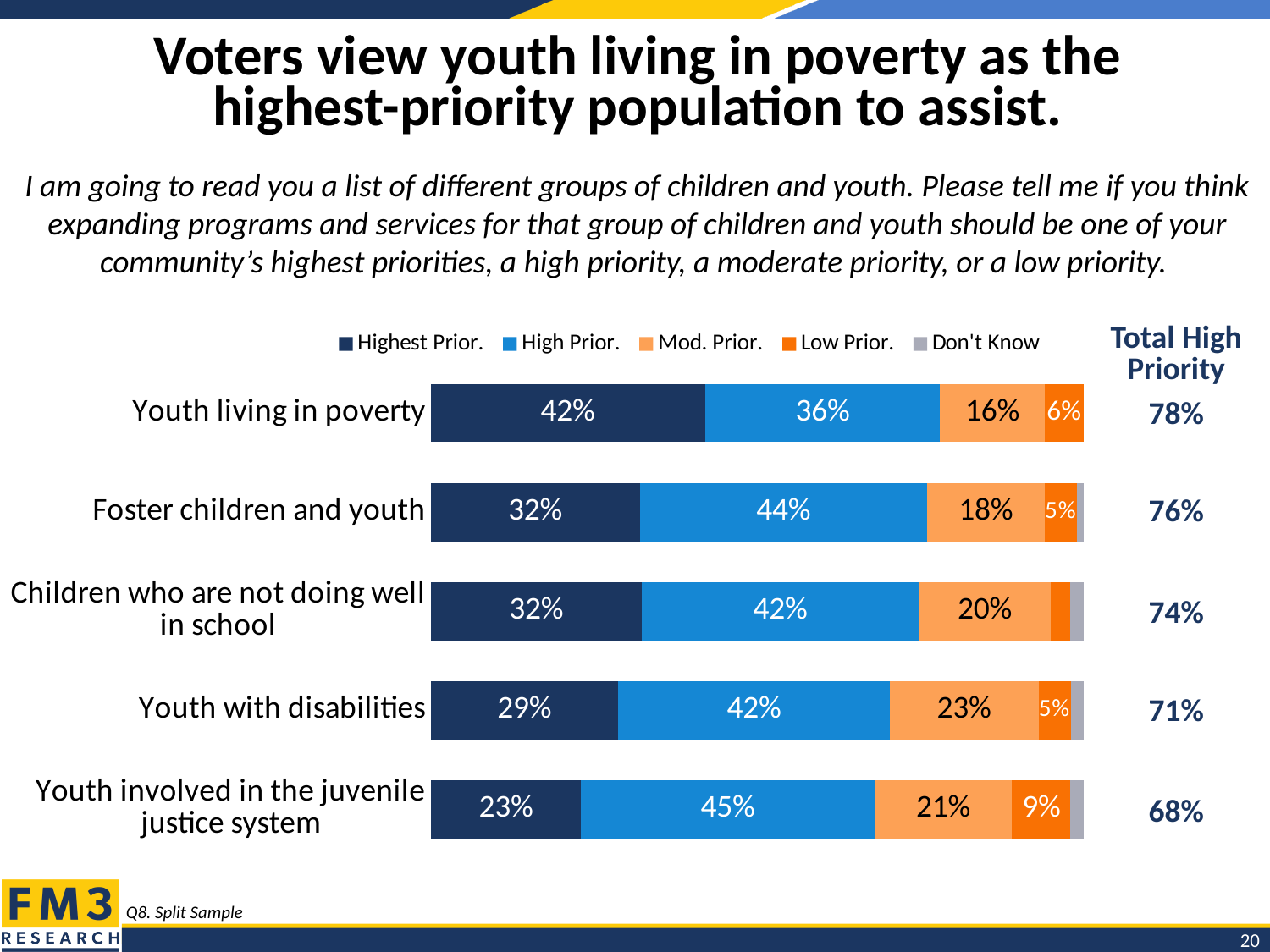
What is the High Prior. value for Foster children and youth? 44% What is the Mod. Prior. value for Youth with disabilities? 23% Which group has the highest Highest Prior. percentage? Youth living in poverty How many groups of children and youth are shown in the chart? 5 Which group has the lowest Total High Priority value? Youth involved in the juvenile justice system What is the difference in Highest Prior. percentage between Youth living in poverty and Youth involved in the juvenile justice system? 19 percentage points What kind of chart is shown on the slide? Stacked bar chart How many series does the legend list? 5 Which has a larger High Prior. value: Foster children and youth or Youth living in poverty? Foster children and youth What is the Total High Priority value for Children who are not doing well in school? 74% What percentage of voters rated expanding programs for youth living in poverty as the highest priority (Highest Prior.)? 42% What is the Low Prior. value for Youth involved in the juvenile justice system? 9%